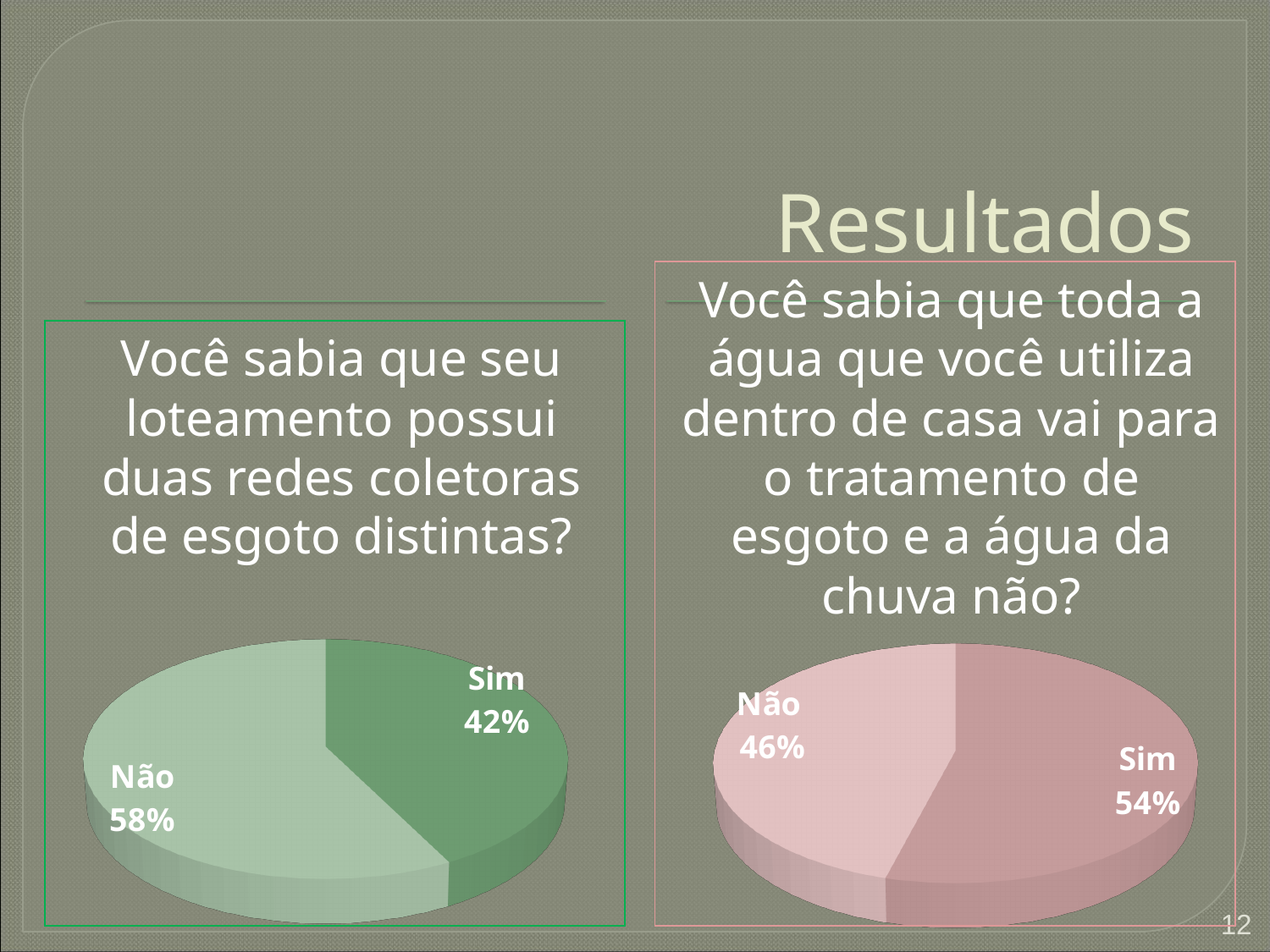
In the left pie chart, what is the difference in percentage points between "Não" and "Sim"? 16 In the left pie chart, which answer has the larger share? Não In the left pie chart (about the loteamento having two sewage collection networks), what percentage answered "Não"? 58% What type of chart is used on the left side of the slide? Pie chart What is the title of the slide? Resultados How many slices does the right pie chart have? 2 In the right pie chart (about household water going to sewage treatment and rainwater not), what percentage answered "Não"? 46% In the right pie chart, which answer has the smaller share? Não In the right pie chart, what is the difference in percentage points between "Sim" and "Não"? 8 Is the "Sim" share larger in the left pie chart or in the right pie chart? Right pie chart In the right pie chart (about household water going to sewage treatment and rainwater not), what percentage answered "Sim"? 54% In the left pie chart (about the loteamento having two sewage collection networks), what percentage answered "Sim"? 42%